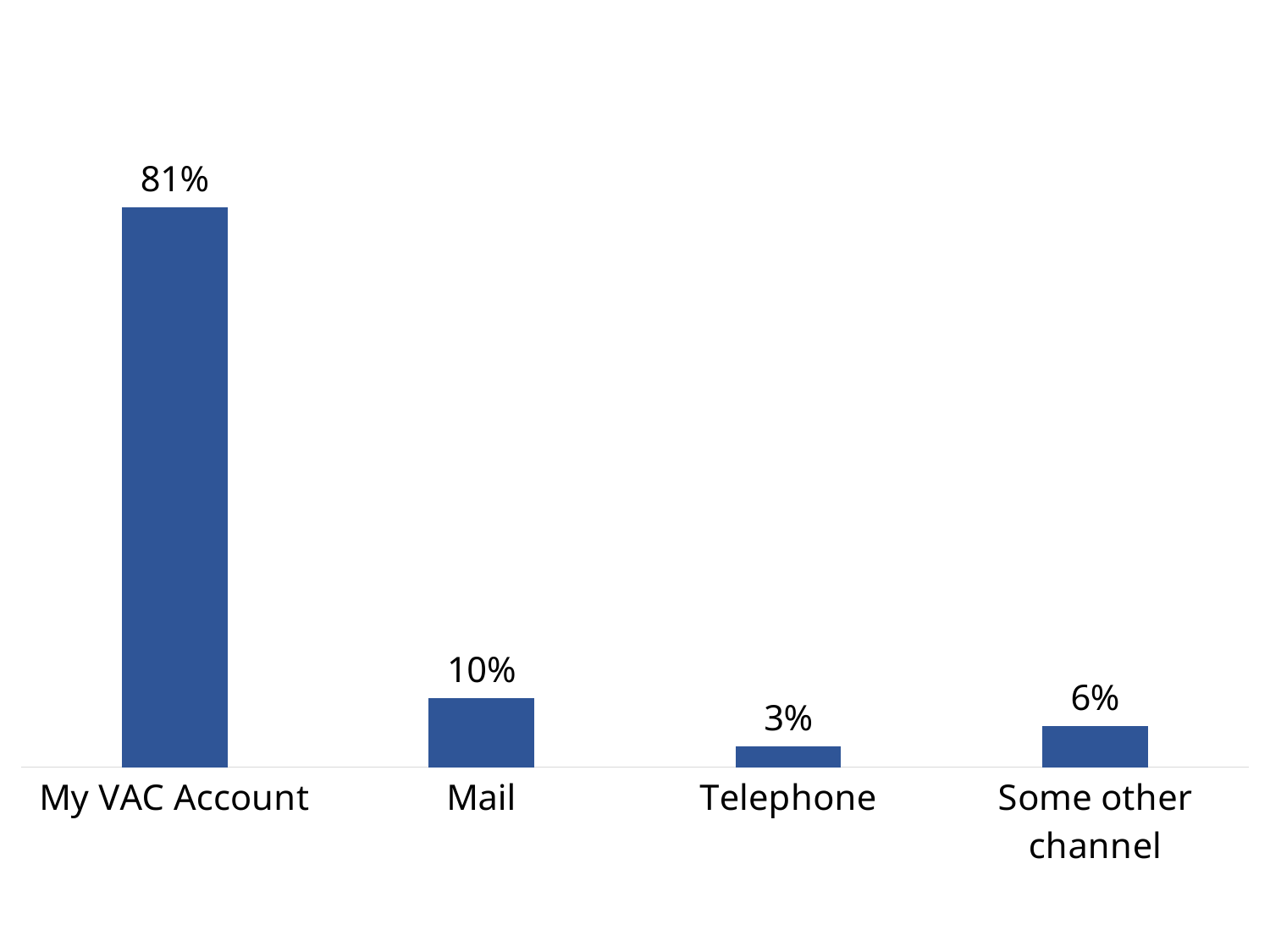
Which category has the lowest value? Telephone Which is larger, the value for Mail or the value for Some other channel? Mail What is the value for Telephone? 3% How many categories are shown on the chart? 4 What is the value for Some other channel? 6% What is the value for My VAC Account? 81% What is the difference between the values for My VAC Account and Mail? 71% What kind of chart is shown on the slide? Bar chart Which category has the highest value? My VAC Account What is the difference between the values for Some other channel and Telephone? 3% What is the value for Mail? 10% What colour are the bars on the chart? Blue